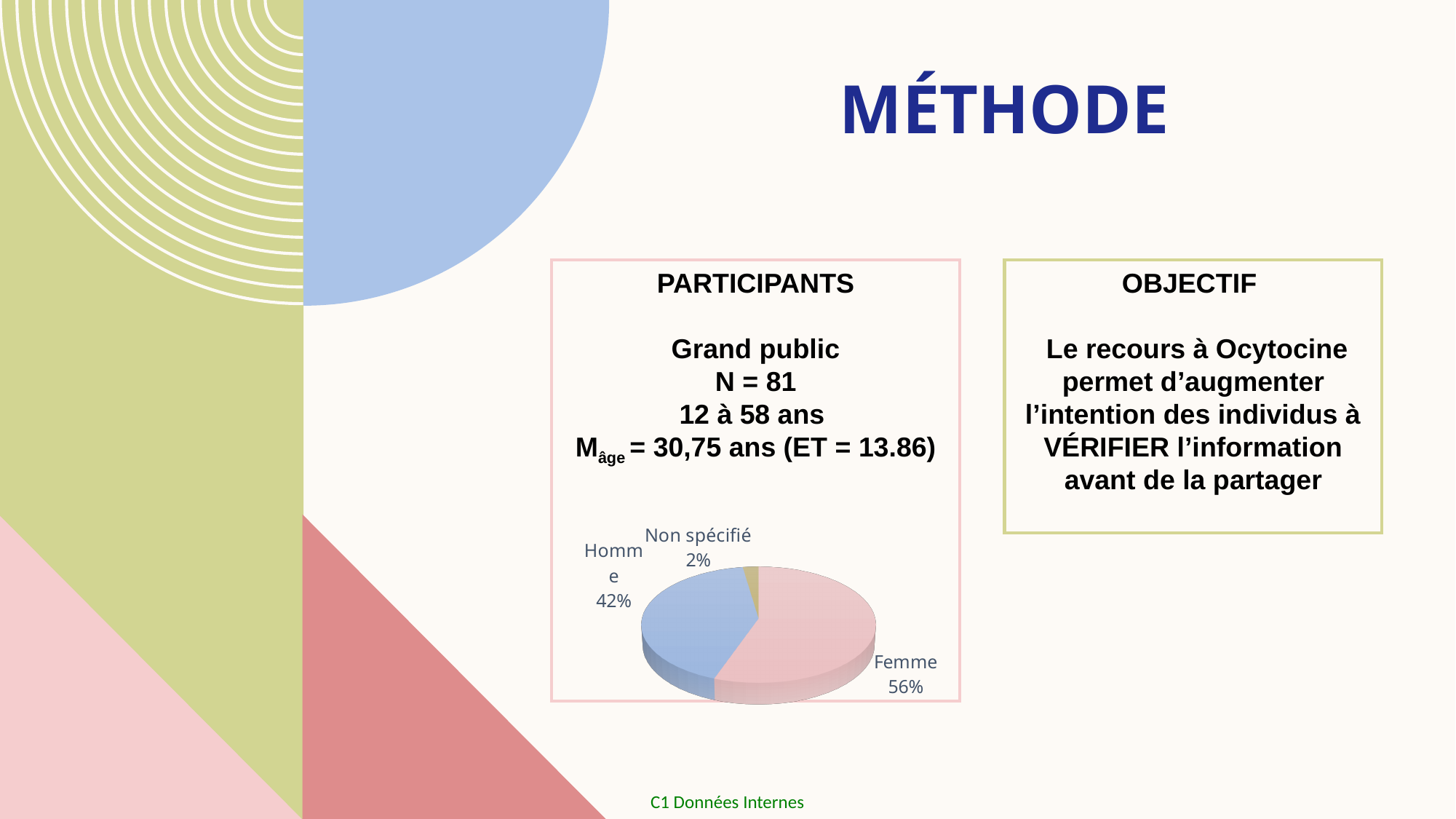
Which slice of the pie chart is the smallest? Non spécifié Which is larger in the pie chart, Homme or Femme? Femme What percentage of participants are labelled Non spécifié in the pie chart? 2% What colour is the Femme slice in the pie chart? pink What percentage of participants are Homme according to the pie chart? 42% What is the difference in percentage points between the Femme and Homme slices? 14 What is the combined share of the Homme and Non spécifié slices? 44% What colour is the Homme slice in the pie chart? blue Which slice of the pie chart is the largest? Femme How many slices does the pie chart have? 3 What percentage of participants are Femme according to the pie chart? 56% What kind of chart is shown in the PARTICIPANTS box? pie chart